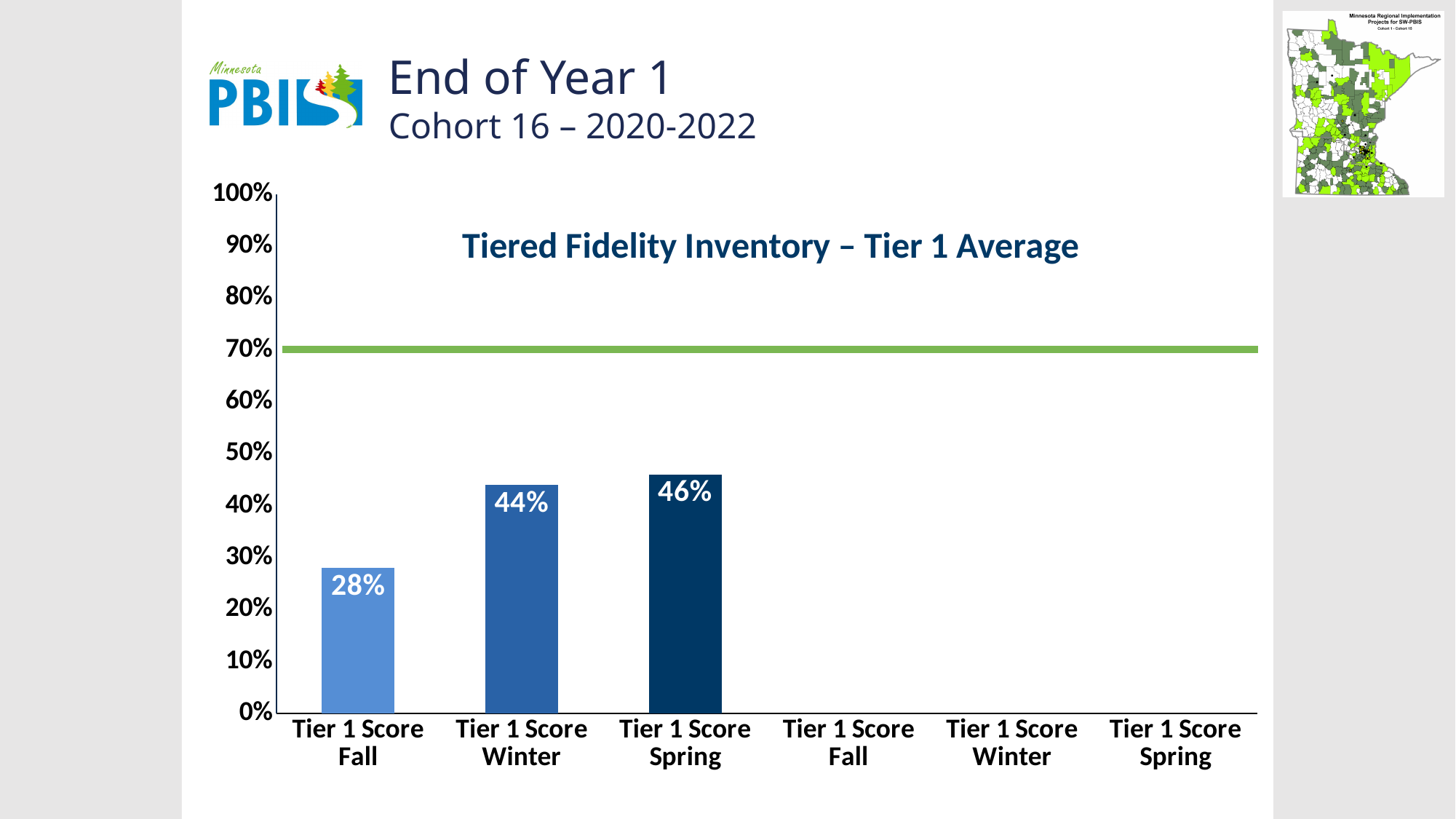
What is the Tier 1 Score for Winter? 44% Which season has the highest Tier 1 Score? Spring What type of chart is shown on the slide? bar chart Do the Tier 1 Scores rise or fall from Fall to Spring? rise What is the Tier 1 Score for Spring? 46% Which season has the lowest Tier 1 Score? Fall What is the difference between the Spring and Fall Tier 1 Scores? 18% What is the Tier 1 Score for Fall in the first set of bars? 28% What is the title of the chart? Tiered Fidelity Inventory – Tier 1 Average How many bars are plotted with values in the chart? 3 Is the Tier 1 Score for Winter greater or less than 40%? greater What is the difference between the Winter and Fall Tier 1 Scores? 16%